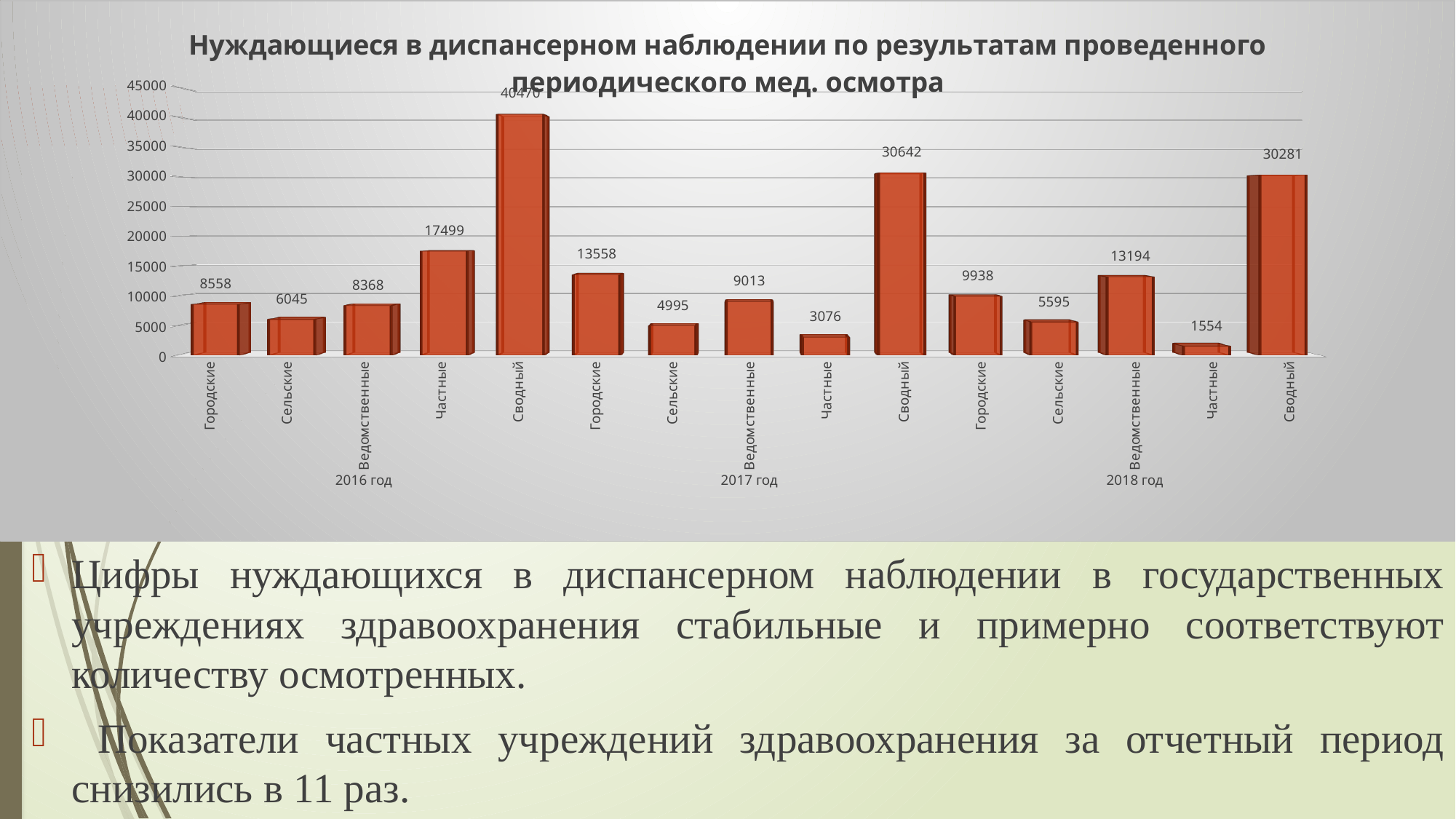
What is the value for Частные in 2016 год? 17499 Which category has the lowest value in 2018 год? Частные Which is larger: Городские in 2017 год or Городские in 2018 год? Городские in 2017 год What is the difference between Частные in 2016 год and Частные in 2018 год? 15945 How many bars are plotted in the chart? 15 What is the value for Сводный in 2017 год? 30642 How does the value for Частные change from 2016 год to 2018 год? It falls Which category has the highest value in 2017 год? Сводный What is the value for Ведомственные in 2018 год? 13194 What kind of chart is shown on the slide? Bar chart Is the value for Сводный in 2016 год greater or less than 35000? greater What is the value for Сельские in 2017 год? 4995